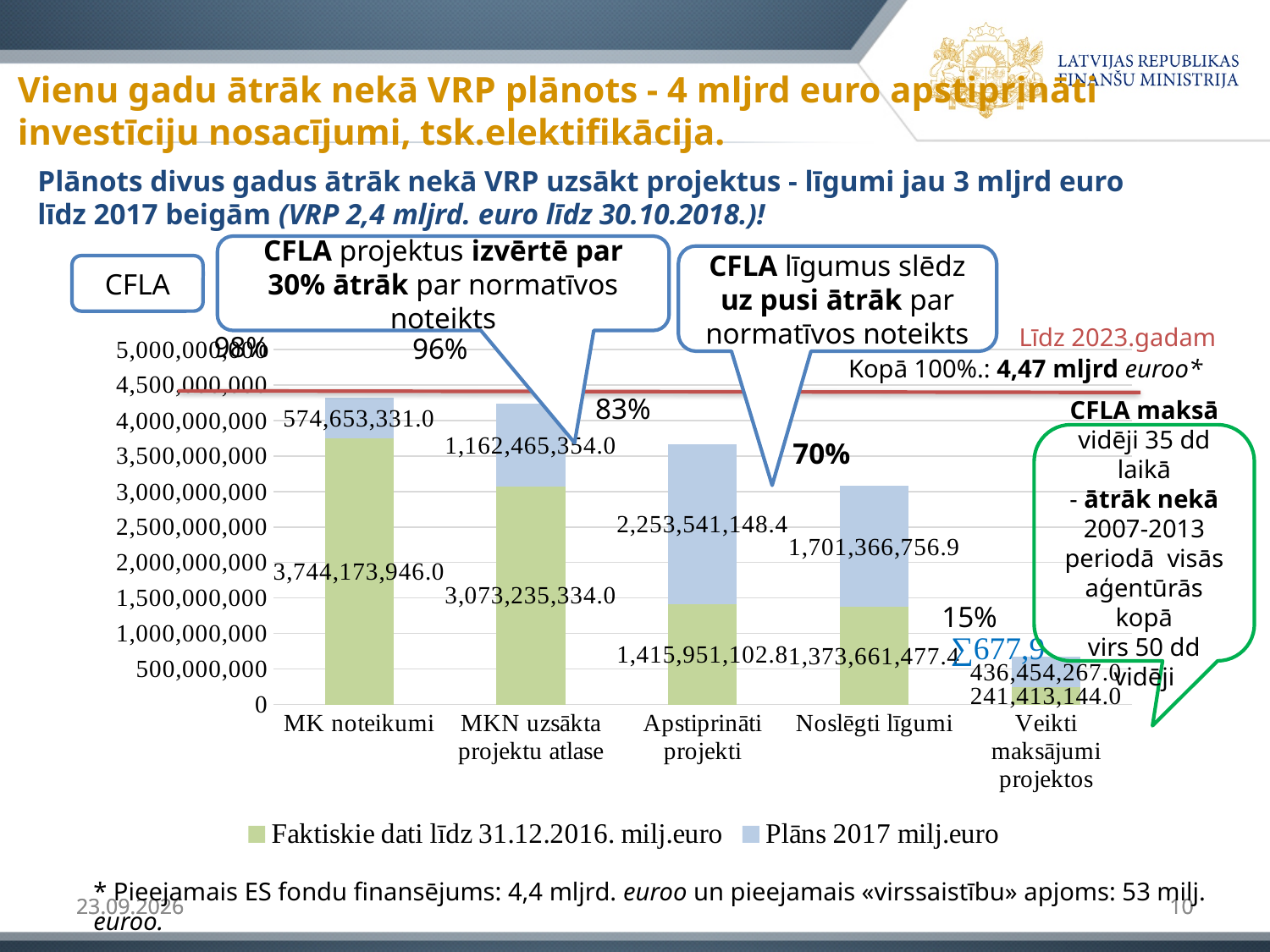
What is the value of the 'Faktiskie dati līdz 31.12.2016. milj.euro' series for MK noteikumi? 3,744,173,946.0 What is the value of the 'Plāns 2017 milj.euro' series for MKN uzsākta projektu atlase? 1,162,465,354.0 What is the value of the 'Faktiskie dati līdz 31.12.2016. milj.euro' series for Veikti maksājumi projektos? 241,413,144.0 What is the value of the 'Plāns 2017 milj.euro' series for Apstiprināti projekti? 2,253,541,148.4 How many series does the chart legend list? 2 Which category has the lowest value in the 'Plāns 2017 milj.euro' series? Veikti maksājumi projektos Which is larger: the 'Plāns 2017 milj.euro' value for Apstiprināti projekti or for Noslēgti līgumi? Apstiprināti projekti What is the difference between the 'Faktiskie dati līdz 31.12.2016. milj.euro' values for MK noteikumi and MKN uzsākta projektu atlase? 670,938,612.0 Is the total stacked value for Apstiprināti projekti greater or less than 3,500,000,000? greater What is the total of the stacked bar for Veikti maksājumi projektos? 677,867,411.0 How many categories are shown on the x axis of the chart? 5 Which category has the highest value in the 'Faktiskie dati līdz 31.12.2016. milj.euro' series? MK noteikumi